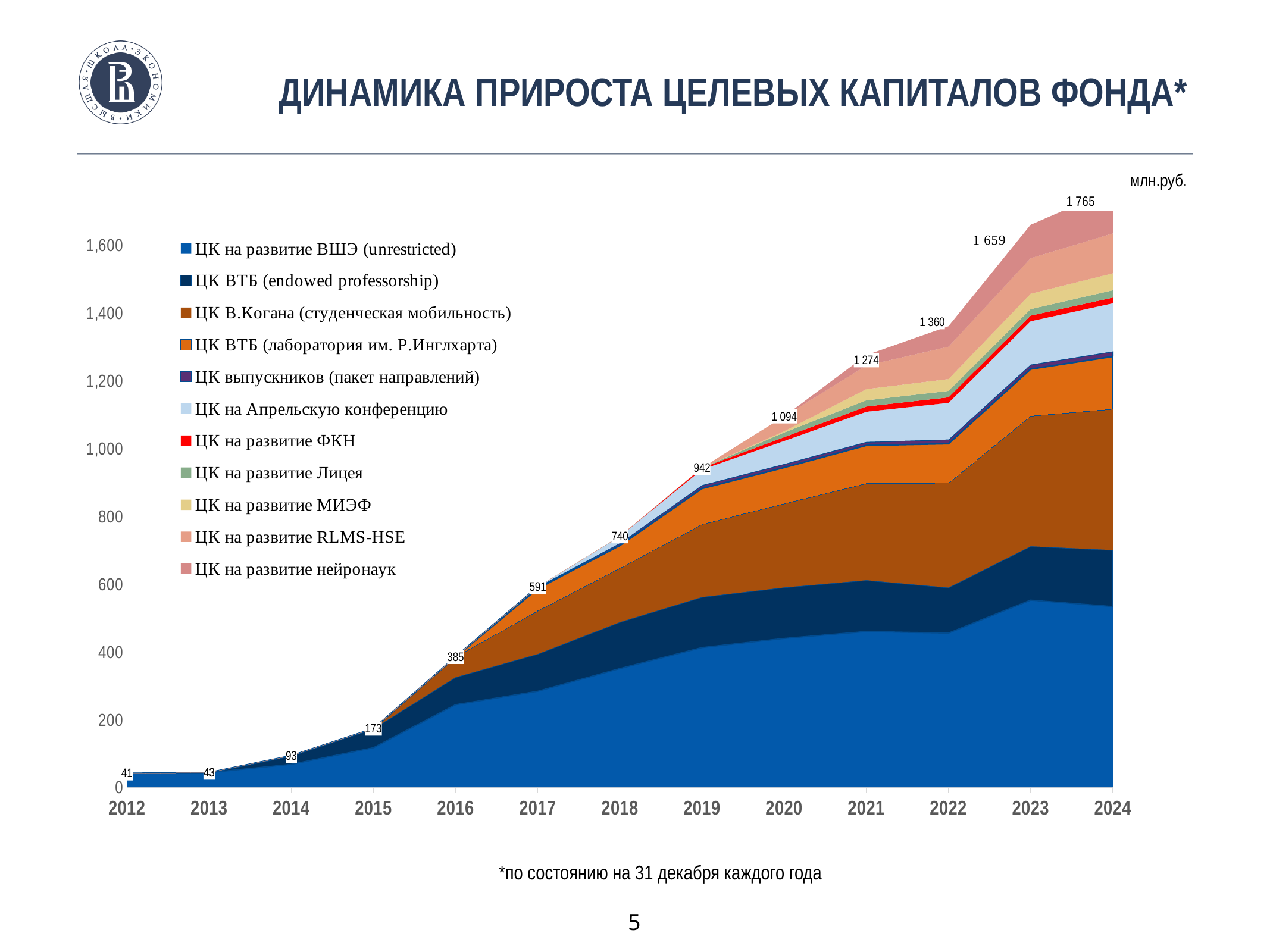
Do the labelled totals rise or fall from 2012 to 2024? Rise How many series does the legend list? 11 What is the total value labelled for 2020? 1 094 How many years are shown on the x axis? 13 Which year has the highest labelled total? 2024 What kind of chart is shown on the slide? Stacked area chart What is the difference between the labelled totals for 2024 and 2023? 106 What is the total value labelled for 2024? 1 765 What is the difference between the labelled totals for 2019 and 2018? 202 Which year has the lowest labelled total? 2012 Which is larger, the labelled total for 2017 or for 2018? 2018 What is the total value labelled for 2016? 385